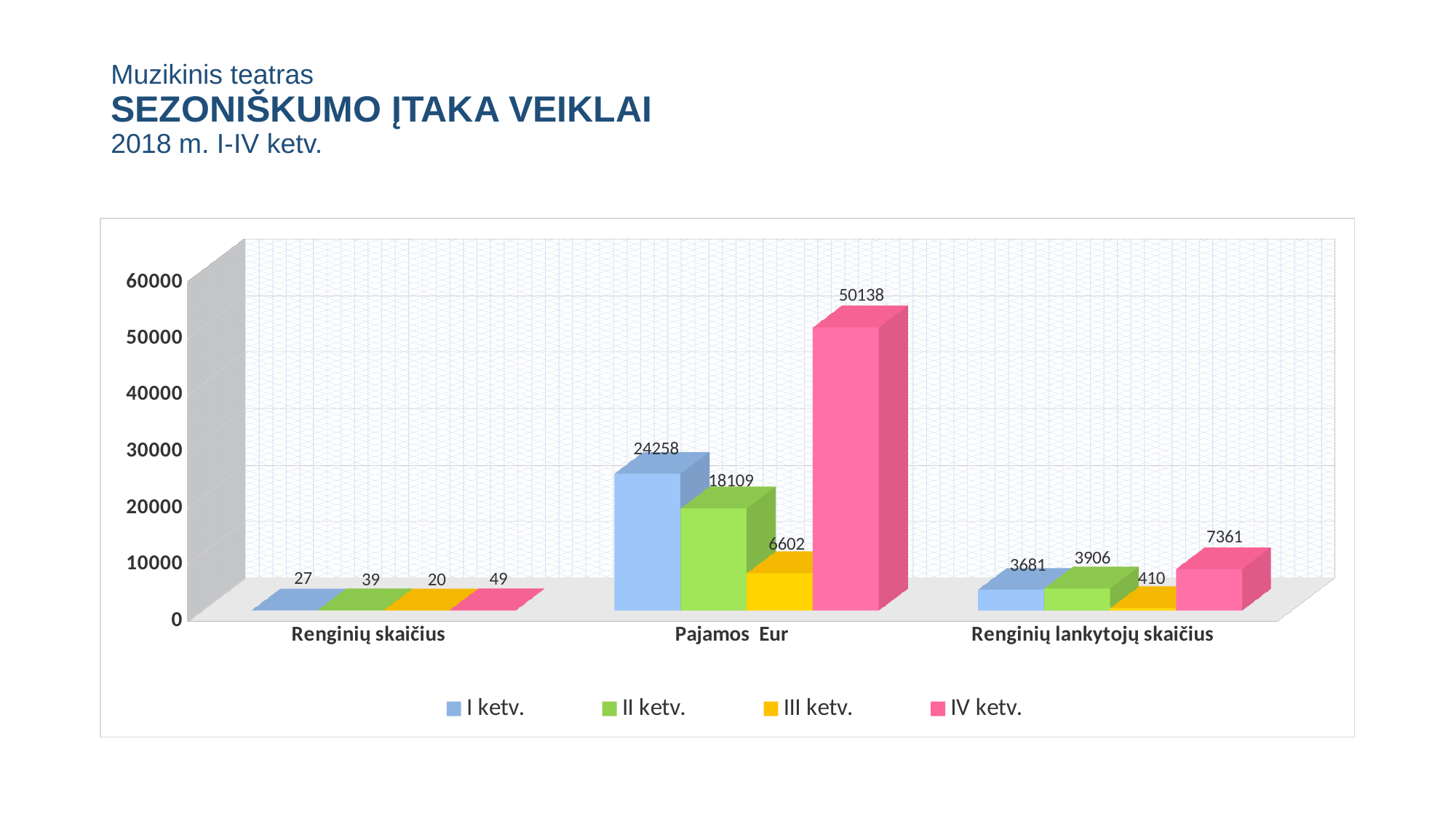
What kind of chart is shown on the slide? Bar chart Which colour represents IV ketv. in the legend? Pink What is the difference between the IV ketv. and I ketv. values in the Pajamos Eur category? 25880 Which quarter has the highest value in the Pajamos Eur category? IV ketv. Which is larger in the Renginių lankytojų skaičius category: I ketv. or II ketv.? II ketv. Which quarter has the lowest value in the Renginių lankytojų skaičius category? III ketv. What is the value for II ketv. in the Renginių skaičius category? 39 What is the value for III ketv. in the Renginių lankytojų skaičius category? 410 How many series does the legend list? 4 What is the value for IV ketv. in the Pajamos Eur category? 50138 Is the value for IV ketv. in the Pajamos Eur category greater or less than 40000? greater How many categories are shown on the x axis? 3